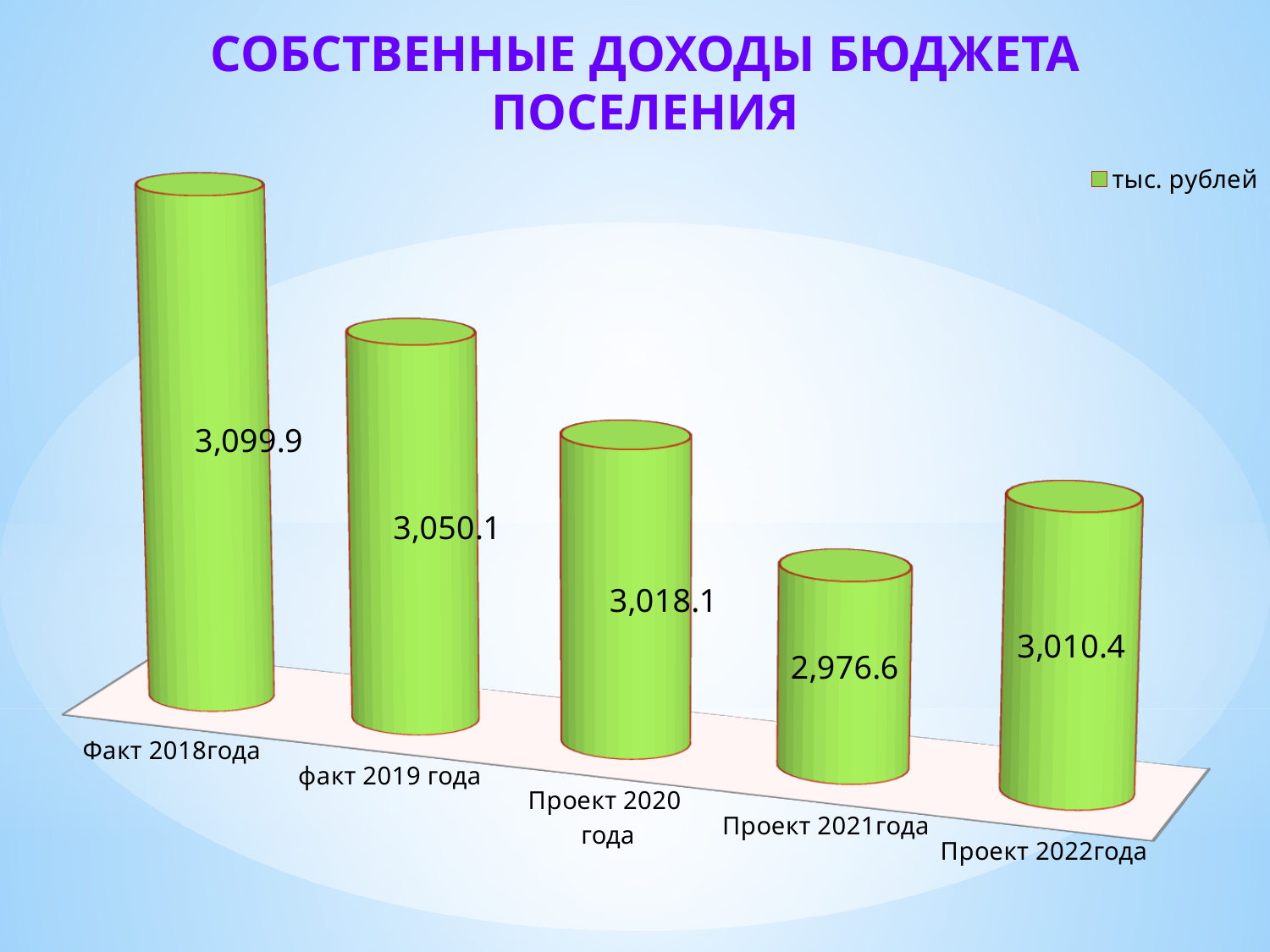
What is the difference between the values for Факт 2018года and факт 2019 года? 49.8 What is the value for Проект 2020 года? 3,018.1 Which category has the highest value? Факт 2018года What is the value for Факт 2018года? 3,099.9 Which category has the lowest value? Проект 2021года What is the difference between the values for Проект 2022года and Проект 2021года? 33.8 What unit does the legend give for the values? тыс. рублей How many categories are shown in the chart? 5 What is the value for Проект 2021года? 2,976.6 What is the value for Проект 2022года? 3,010.4 Which is larger, the value for Проект 2020 года or the value for Проект 2022года? Проект 2020 года What is the value for факт 2019 года? 3,050.1